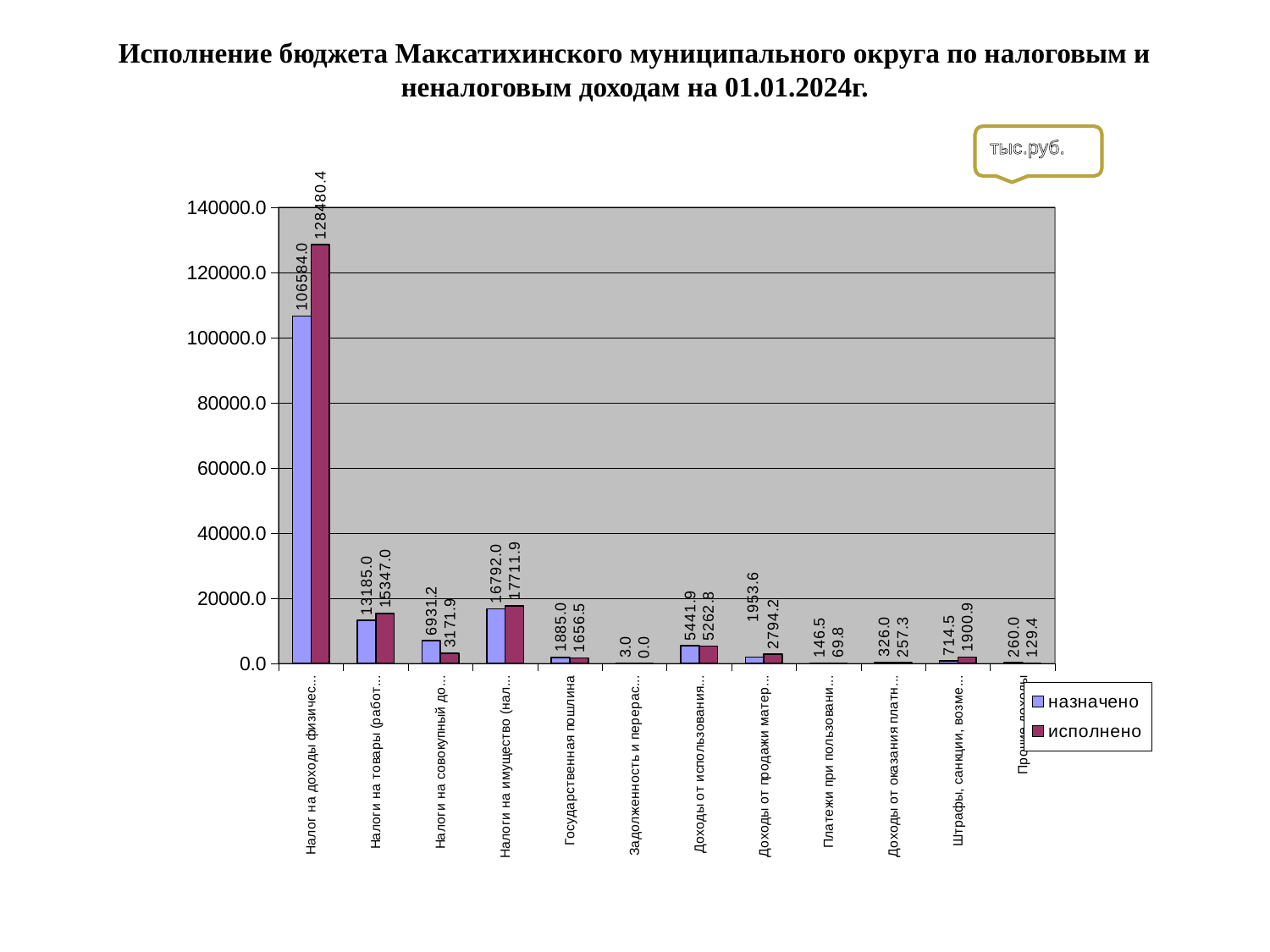
What is the 'назначено' value for the category 'Штрафы, санкции, возме...'? 714.5 For the category 'Налоги на совокупный до...', which is larger: 'назначено' or 'исполнено'? назначено What is the 'исполнено' value for the first category, 'Налог на доходы физичес...'? 128480.4 How many categories are plotted along the x axis? 12 How many series does the legend list? 2 What is the 'исполнено' value for the category 'Государственная пошлина'? 1656.5 What is the 'назначено' value for the category 'Государственная пошлина'? 1885.0 What kind of chart is shown on the slide? bar chart What unit is indicated in the callout box on the slide? тыс.руб. Which category has the lowest 'назначено' value? Задолженность и перерас... Which category has the highest 'исполнено' value? Налог на доходы физичес... What is the difference between the 'исполнено' and 'назначено' values for the first category, 'Налог на доходы физичес...'? 21896.4